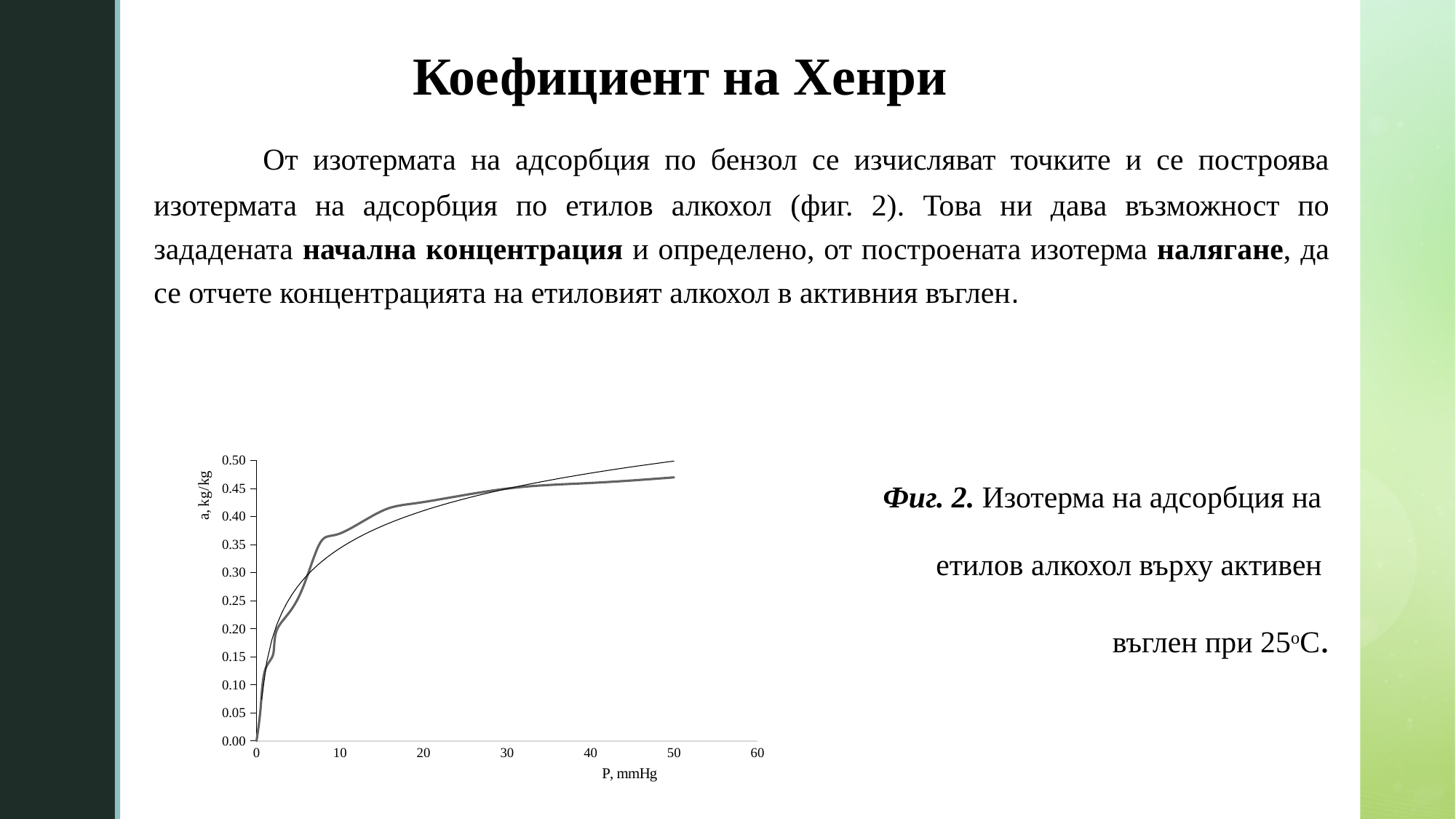
What is the label of the y axis of the chart? a, kg/kg Do the plotted values rise or fall as P increases along the x axis? rise How many lines are plotted on the chart? 2 What kind of chart is shown on the slide? line chart Is the value of the thick line at P = 50 mmHg greater or less than 0.45? greater Is the value of the thick line at P = 20 mmHg greater or less than 0.40? greater What is the highest tick value shown on the x axis? 60 Is the value of the thick line at P = 10 mmHg greater or less than 0.30? greater What is the label of the x axis of the chart? P, mmHg